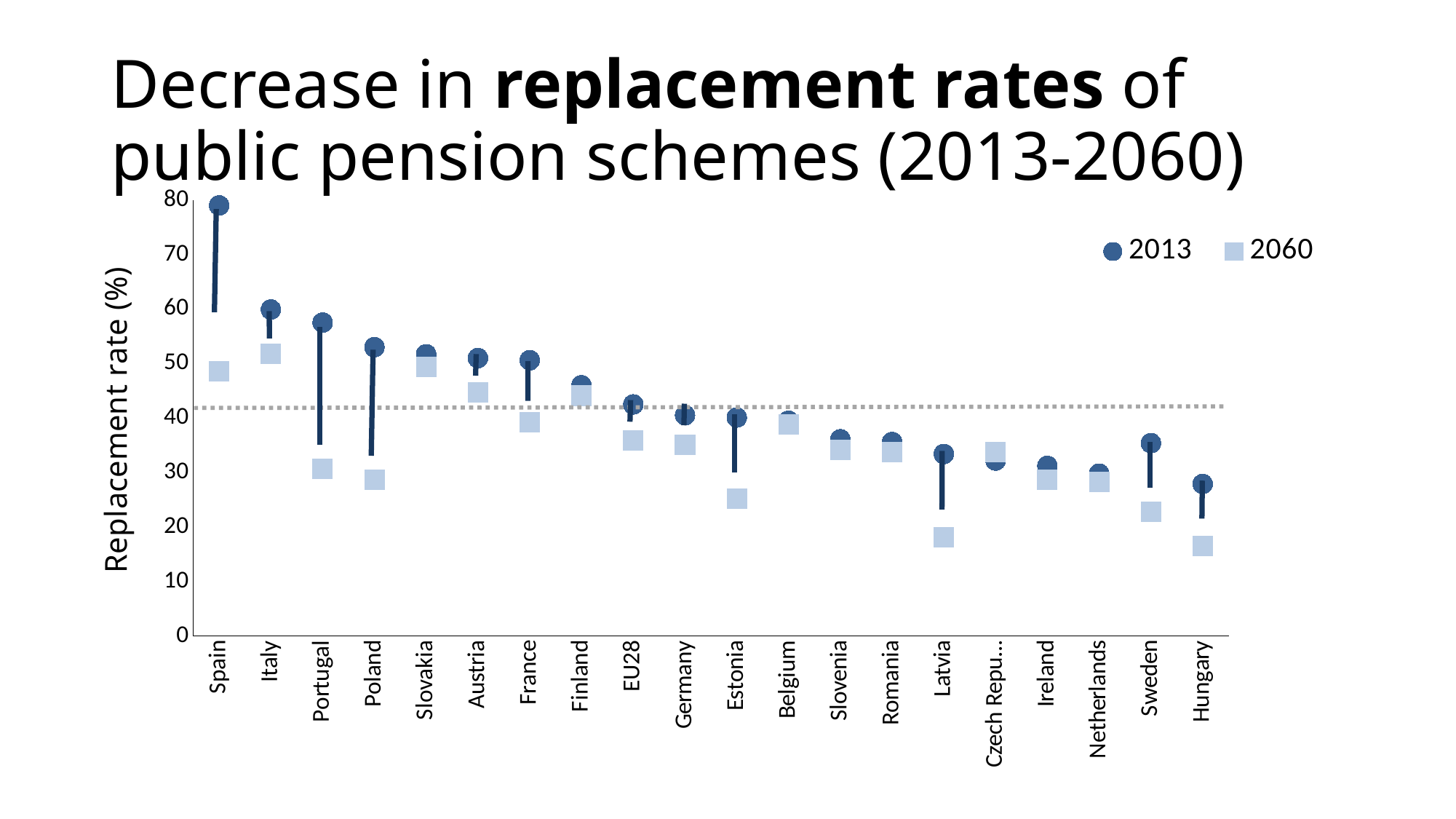
Which is larger: the 2060 value for Slovakia or the 2060 value for Portugal? Slovakia What kind of chart is shown on the slide? Scatter (dot) chart Which country has the lowest 2013 replacement rate? Hungary Is the 2060 value for Estonia greater or less than 30? less What is the label of the y axis? Replacement rate (%) Is the 2060 value for Portugal greater or less than 40? less How many countries/regions are shown on the x axis? 20 Which country has the highest 2013 replacement rate? Spain Do the 2013 values generally rise or fall moving from left to right along the x axis? fall How many series does the legend list? 2 Which country has the lowest 2060 replacement rate? Hungary Is the 2013 value for Spain greater or less than 70? greater